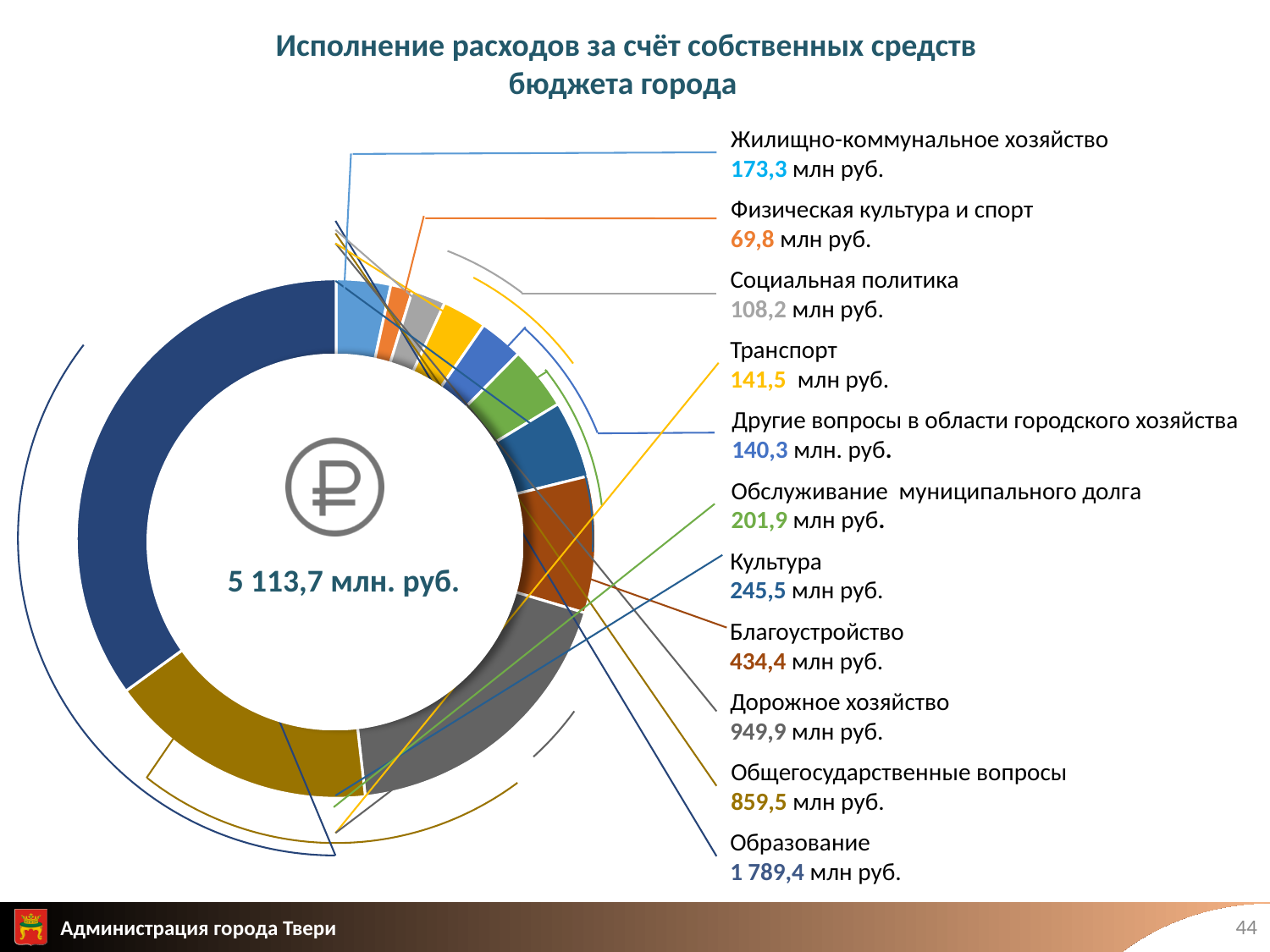
What is the value for Дорожное хозяйство? 949,9 млн руб. What is the title of the chart? Исполнение расходов за счёт собственных средств бюджета города How many categories are shown in the chart? 11 What is the difference between Дорожное хозяйство and Общегосударственные вопросы? 90,4 млн руб. Which category has the highest value? Образование What kind of chart is shown on the slide? Pie (doughnut) chart What is the value for Образование? 1 789,4 млн руб. What is the value for Благоустройство? 434,4 млн руб. Which category has the lowest value? Физическая культура и спорт Which is larger, Культура or Обслуживание муниципального долга? Культура What is the value for Физическая культура и спорт? 69,8 млн руб. What total is shown in the centre of the chart? 5 113,7 млн. руб.